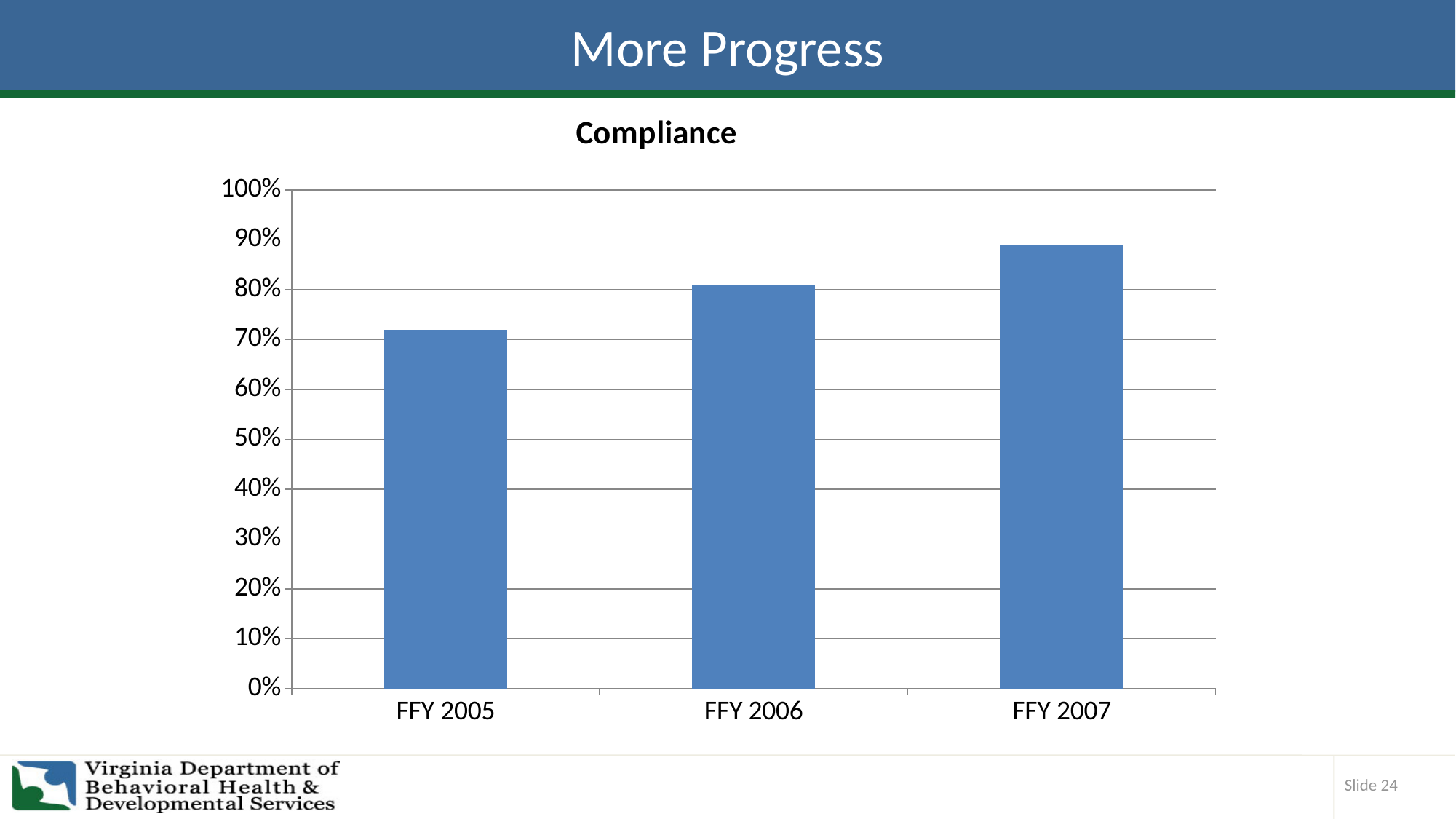
Is the compliance value for FFY 2005 greater or less than 60%? greater What type of chart is shown on the slide? bar chart How many bars are plotted in the chart? 3 Is the compliance value for FFY 2006 greater or less than 70%? greater What is the maximum value shown on the vertical axis? 100% Is the compliance value for FFY 2005 greater or less than 80%? less Which is larger, the compliance value for FFY 2006 or for FFY 2005? FFY 2006 What is the title of the chart? Compliance Which year has the lowest compliance value? FFY 2005 Do the compliance values rise or fall from FFY 2005 to FFY 2007? rise Which year has the highest compliance value? FFY 2007